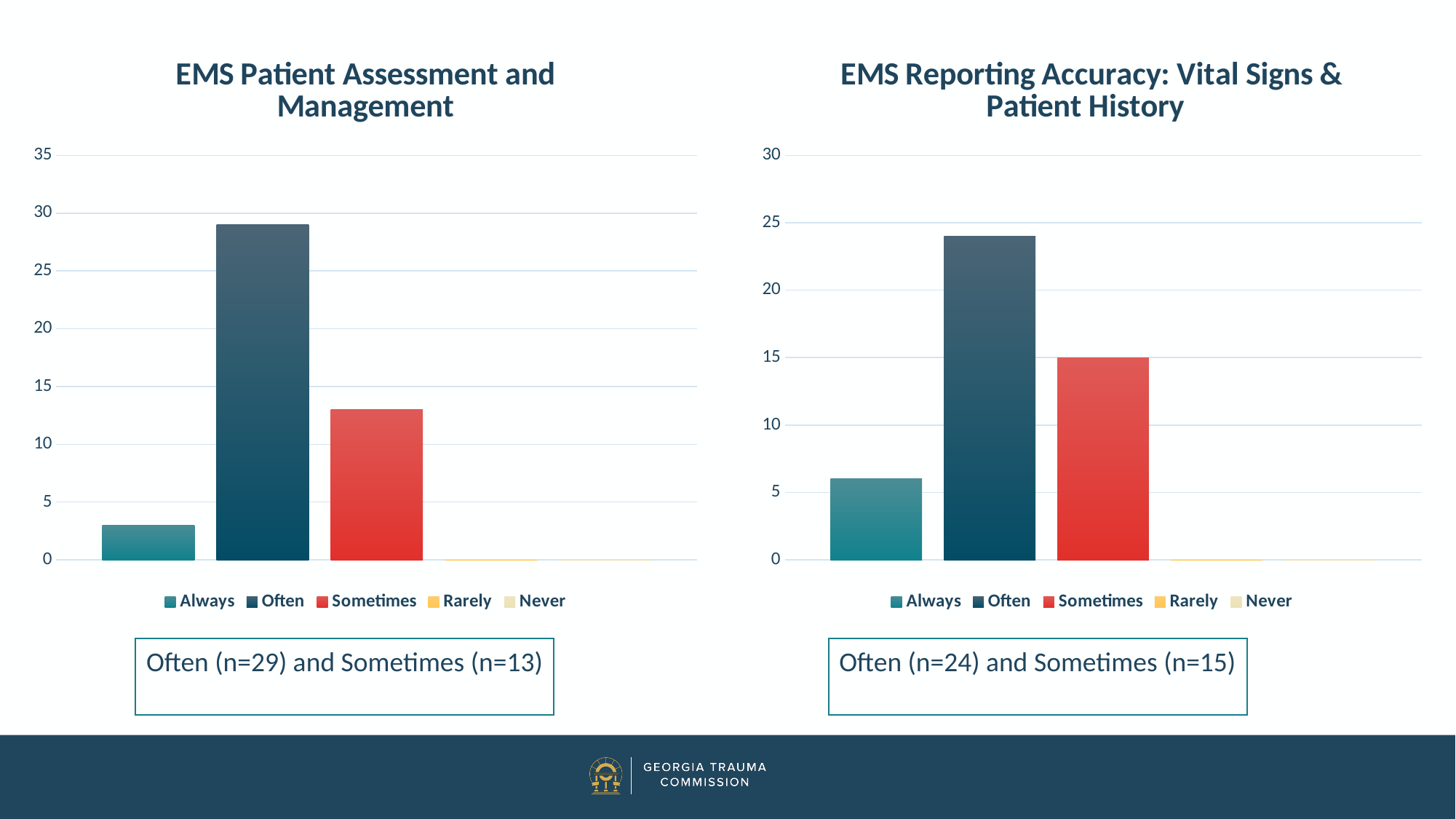
In the EMS Patient Assessment and Management chart, what is the value for Often? 29 What kind of chart is the EMS Reporting Accuracy: Vital Signs & Patient History chart? bar chart In the EMS Patient Assessment and Management chart, what is the difference between the Often and Sometimes values? 16 In the EMS Reporting Accuracy: Vital Signs & Patient History chart, what is the difference between the Often and Sometimes values? 9 How many series does the legend of the EMS Patient Assessment and Management chart list? 5 In the EMS Reporting Accuracy: Vital Signs & Patient History chart, what is the value for Sometimes? 15 In the EMS Reporting Accuracy: Vital Signs & Patient History chart, is the value for Always greater or less than 5? greater In the EMS Patient Assessment and Management chart, is the value for Always greater or less than 5? less In the EMS Reporting Accuracy: Vital Signs & Patient History chart, which response has the highest value? Often In the EMS Patient Assessment and Management chart, what is the value for Sometimes? 13 In the EMS Patient Assessment and Management chart, which response has the highest value? Often In the EMS Reporting Accuracy: Vital Signs & Patient History chart, what is the value for Often? 24